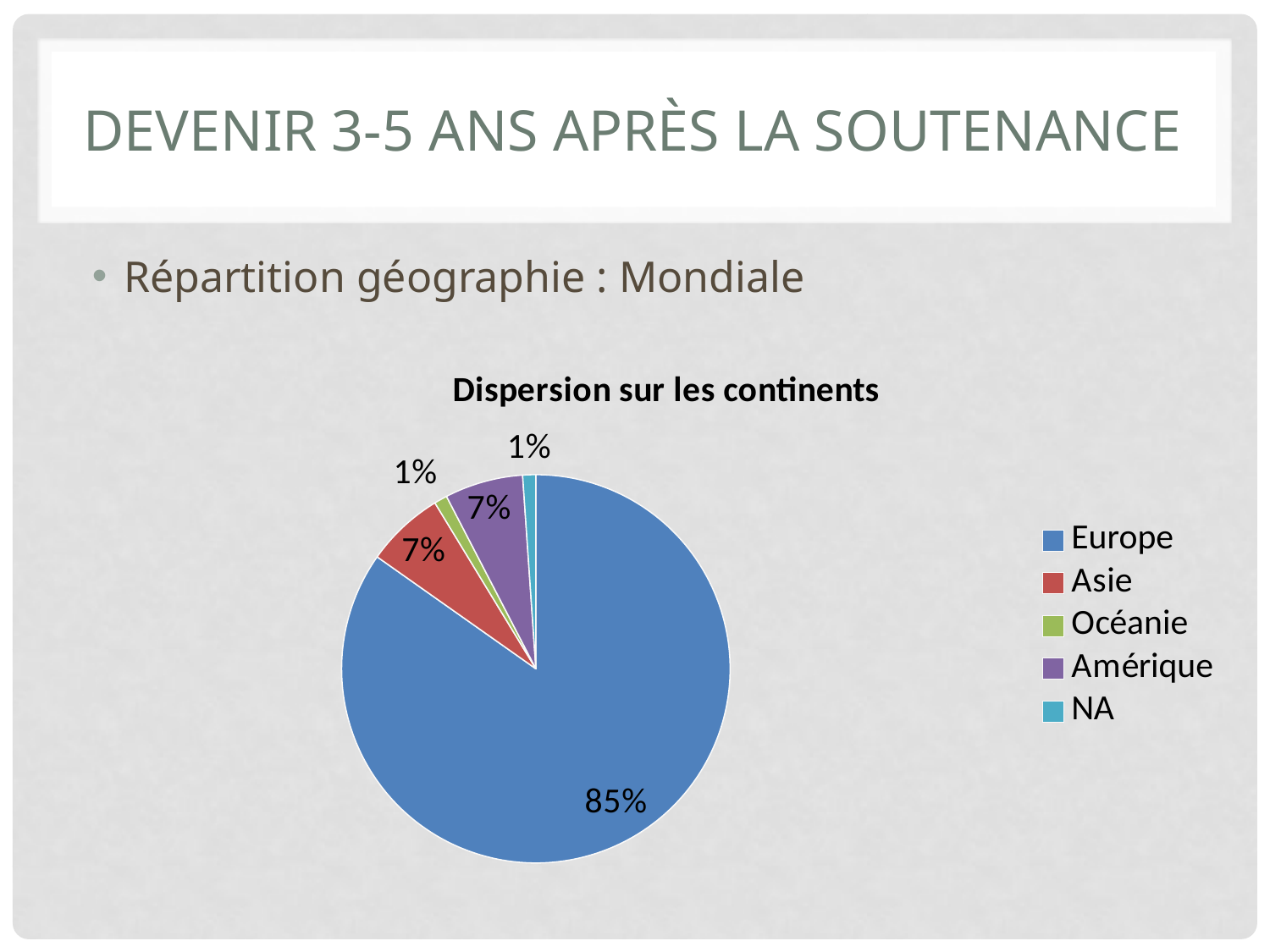
What is the title of the chart? Dispersion sur les continents Which category has the largest slice of the pie? Europe What percentage is shown for Amérique? 7% What kind of chart is shown on the slide? Pie chart What is the difference in percentage points between Amérique and Océanie? 6 What share of the pie does Europe account for? 85% How many categories does the legend list? 5 What percentage is shown for NA? 1% Which is larger, the share for Europe or the share for Amérique? Europe What percentage is shown for Asie? 7% What percentage is shown for Océanie? 1% What is the difference in percentage points between Europe and Asie? 78